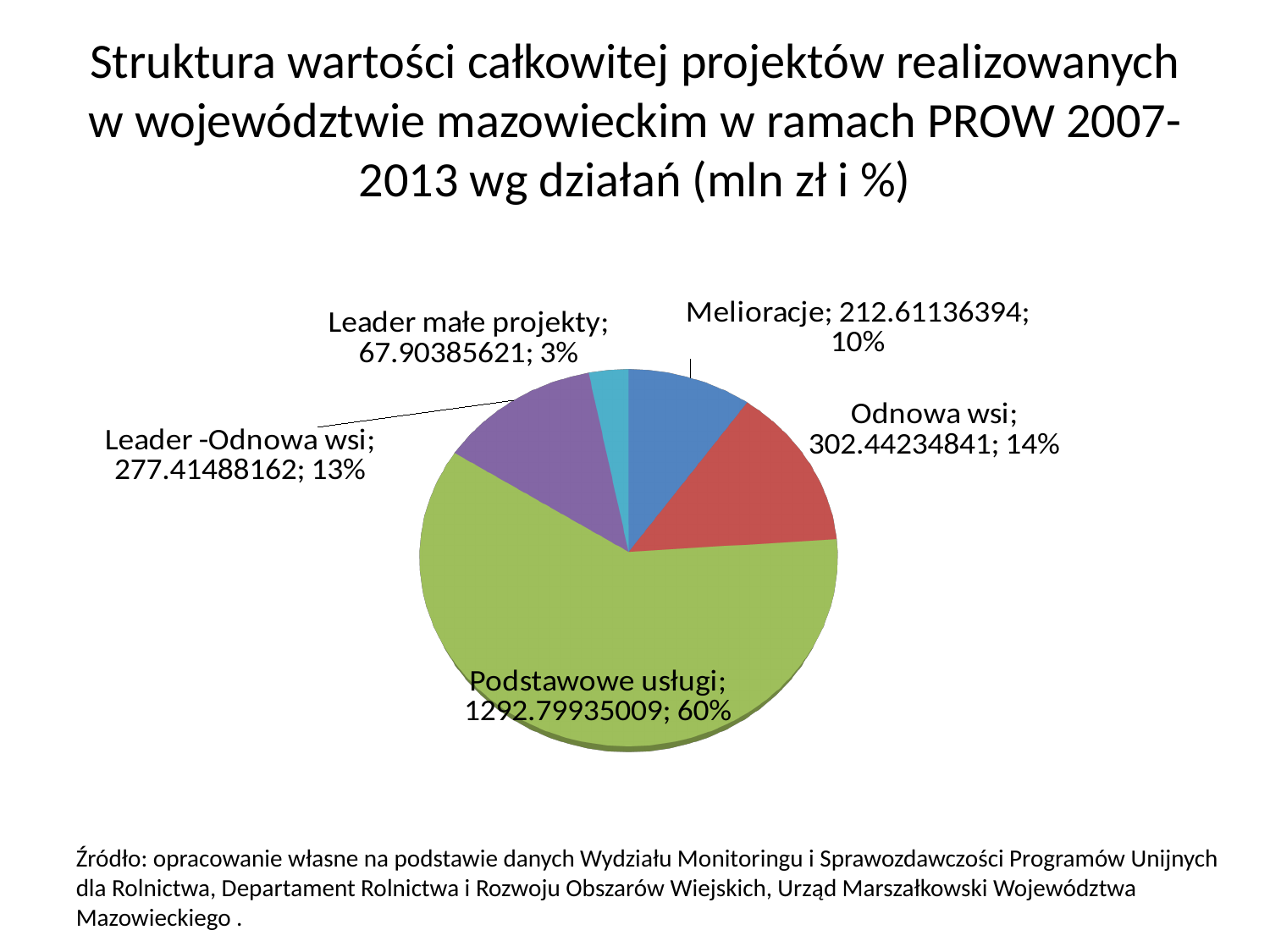
What percentage share of the pie does Leader -Odnowa wsi have? 13% What is the value shown for Odnowa wsi? 302.44234841 Which is larger, the value for Odnowa wsi or the value for Melioracje? Odnowa wsi What is the value shown for Leader małe projekty? 67.90385621 What kind of chart is shown on the slide? pie chart What is the value shown for Melioracje? 212.61136394 What percentage share of the pie does Podstawowe usługi have? 60% How many slices does the pie chart have? 5 Which category has the largest slice of the pie? Podstawowe usługi What is the value shown for Podstawowe usługi? 1292.79935009 What is the difference in percentage share between Odnowa wsi and Melioracje? 4% Which category has the smallest slice of the pie? Leader małe projekty